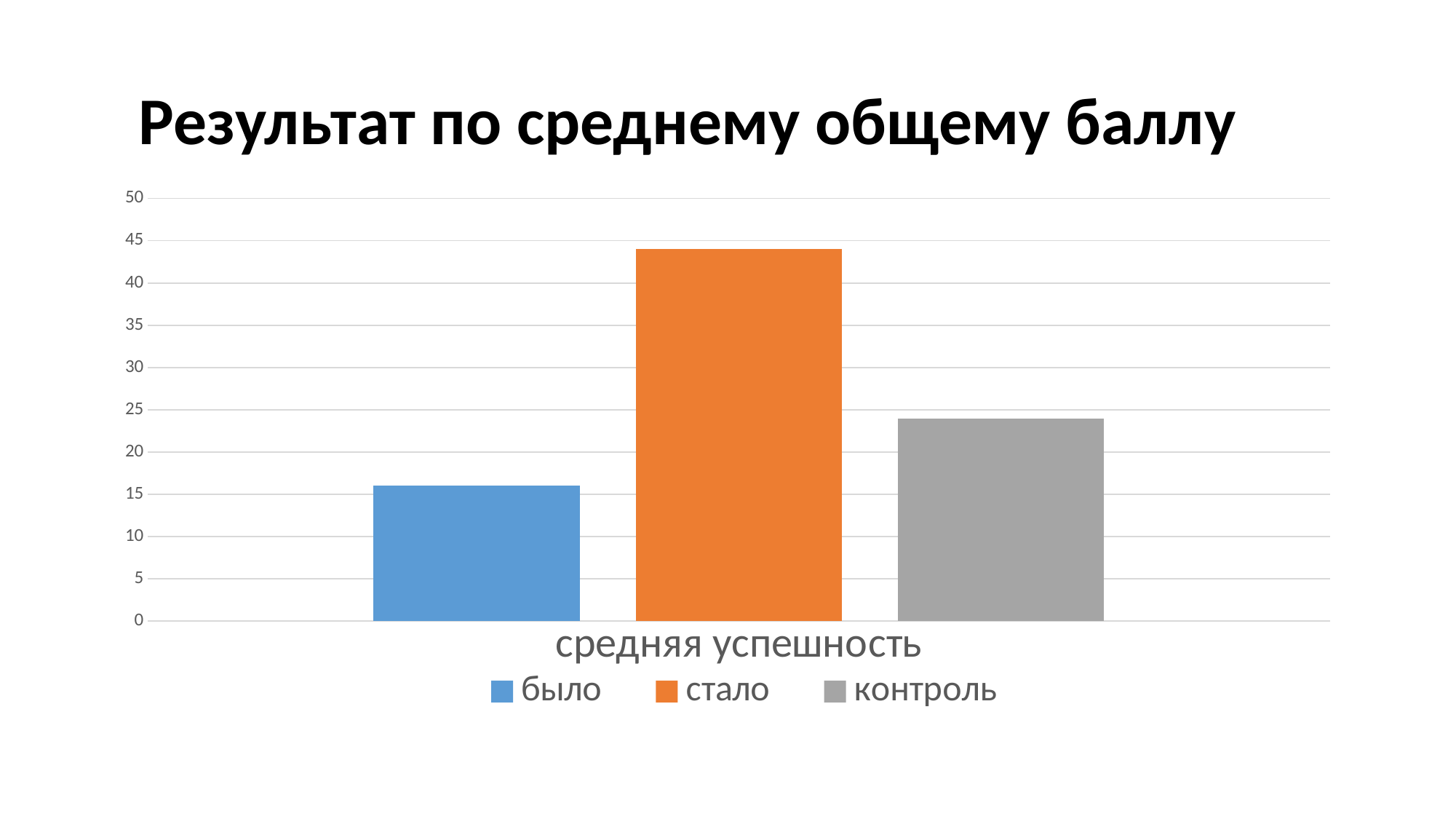
Which series has the lowest value? было Is the value for контроль greater or less than 20? greater What colour is the bar for стало? orange Is the value for было greater or less than 20? less What is the title of the chart? Результат по среднему общему баллу Which series has the highest value? стало How many series does the legend list? 3 Is the value for стало greater or less than 40? greater What kind of chart is shown on the slide? bar chart Which is larger, the value for стало or the value for контроль? стало Which is larger, the value for было or the value for контроль? контроль